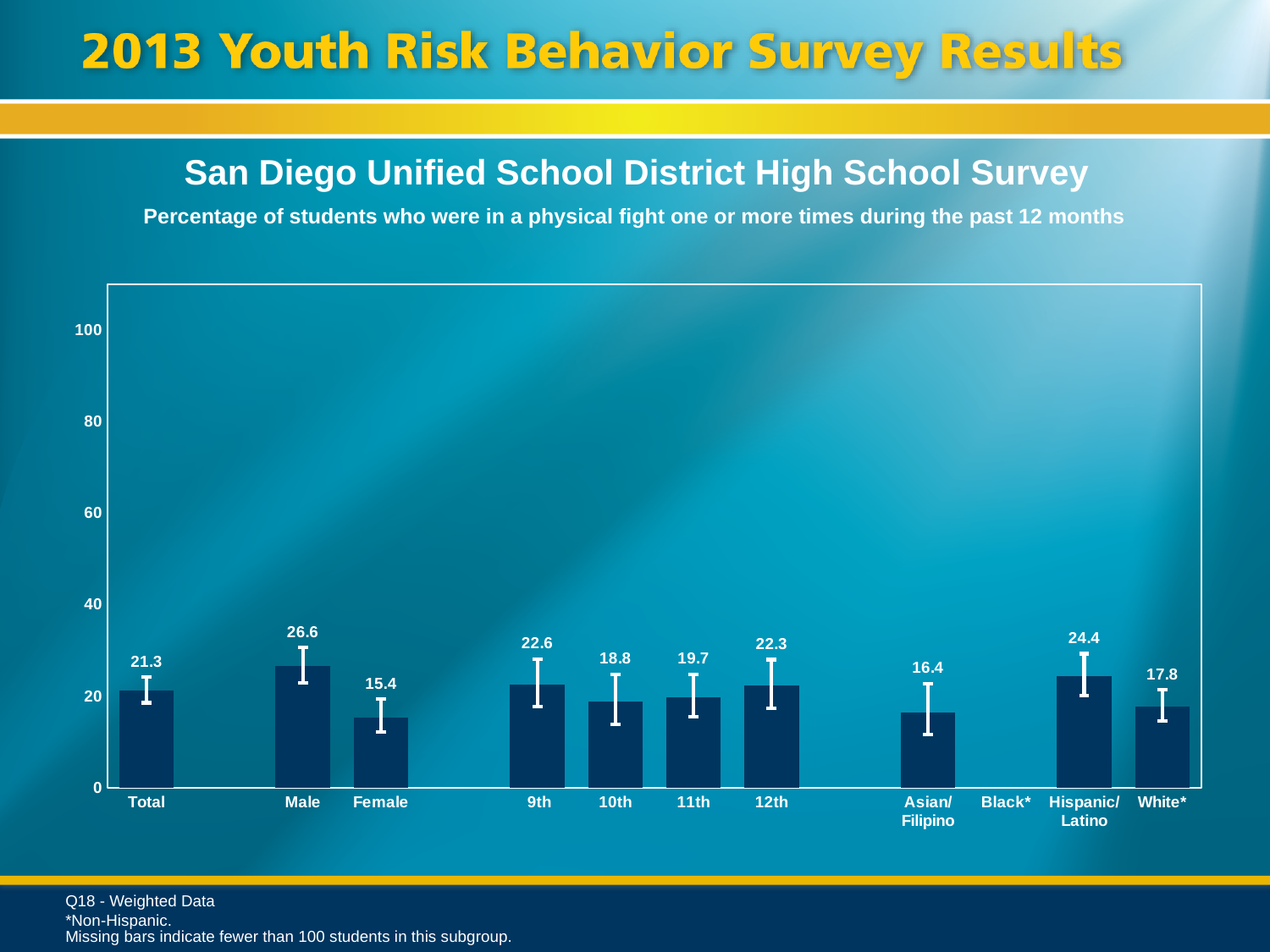
What is the difference between the 9th grade and 10th grade percentages? 3.8 Is the value for Female greater or less than 20? less What is the difference between the Male and Female percentages? 11.2 Which category has the lowest percentage of students who were in a physical fight? Female What is the value shown for Hispanic/Latino students? 24.4 What is the value shown for Male students? 26.6 Which category label has no bar plotted on the chart? Black* How many bars are plotted on the chart? 10 Which is larger, the value for 11th grade or the value for 12th grade? 12th What is the percentage of students who were in a physical fight for the Total category? 21.3 What kind of chart is shown on the slide? bar chart Which category has the highest percentage of students who were in a physical fight? Male